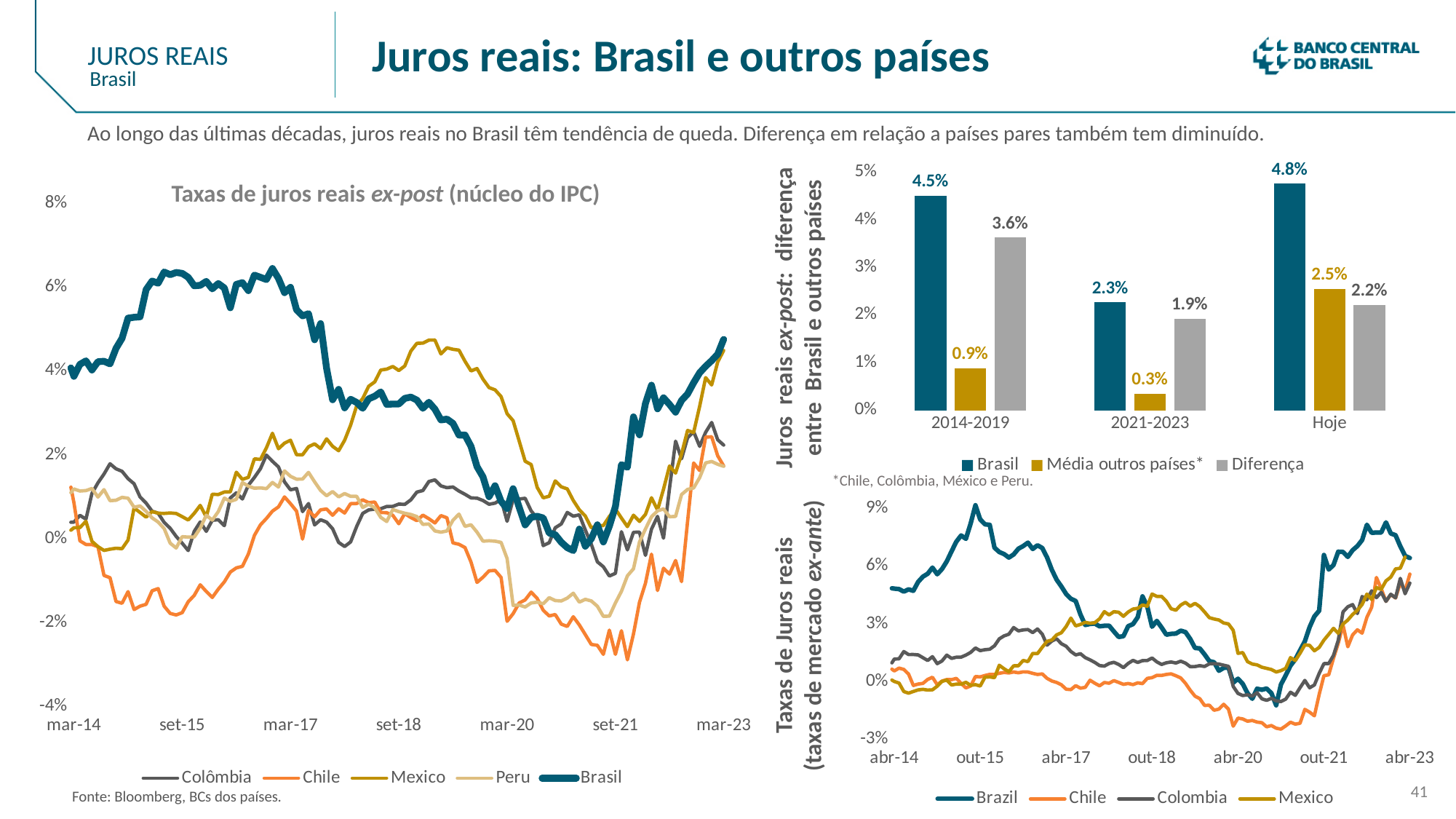
In the bar chart 'Juros reais ex-post: diferença entre Brasil e outros países', what is the 'Diferença' value for Hoje? 2.2% What kind of chart is the left chart 'Taxas de juros reais ex-post (núcleo do IPC)'? Line chart In the bar chart 'Juros reais ex-post: diferença entre Brasil e outros países', in which period is the 'Diferença' value lowest? 2021-2023 In the bar chart 'Juros reais ex-post: diferença entre Brasil e outros países', which is larger: the 'Diferença' for 2014-2019 or the 'Diferença' for Hoje? 2014-2019 How many series does the legend of the left chart 'Taxas de juros reais ex-post (núcleo do IPC)' list? 5 In the bar chart 'Juros reais ex-post: diferença entre Brasil e outros países', what is the value for Brasil in 2014-2019? 4.5% In the bottom-right chart 'Taxas de Juros reais (taxas de mercado ex-ante)', is the Brazil value at abr-23 greater or less than 3%? greater How many series does the legend of the bar chart 'Juros reais ex-post: diferença entre Brasil e outros países' list? 3 In the bar chart 'Juros reais ex-post: diferença entre Brasil e outros países', what is the value of 'Média outros países' for 2021-2023? 0.3% In the bar chart 'Juros reais ex-post: diferença entre Brasil e outros países', what is the difference between the Brasil value and the 'Média outros países' value for Hoje? 2.3% In the bar chart 'Juros reais ex-post: diferença entre Brasil e outros países', in which period is the Brasil value highest? Hoje How many period categories are shown on the x axis of the bar chart 'Juros reais ex-post: diferença entre Brasil e outros países'? 3